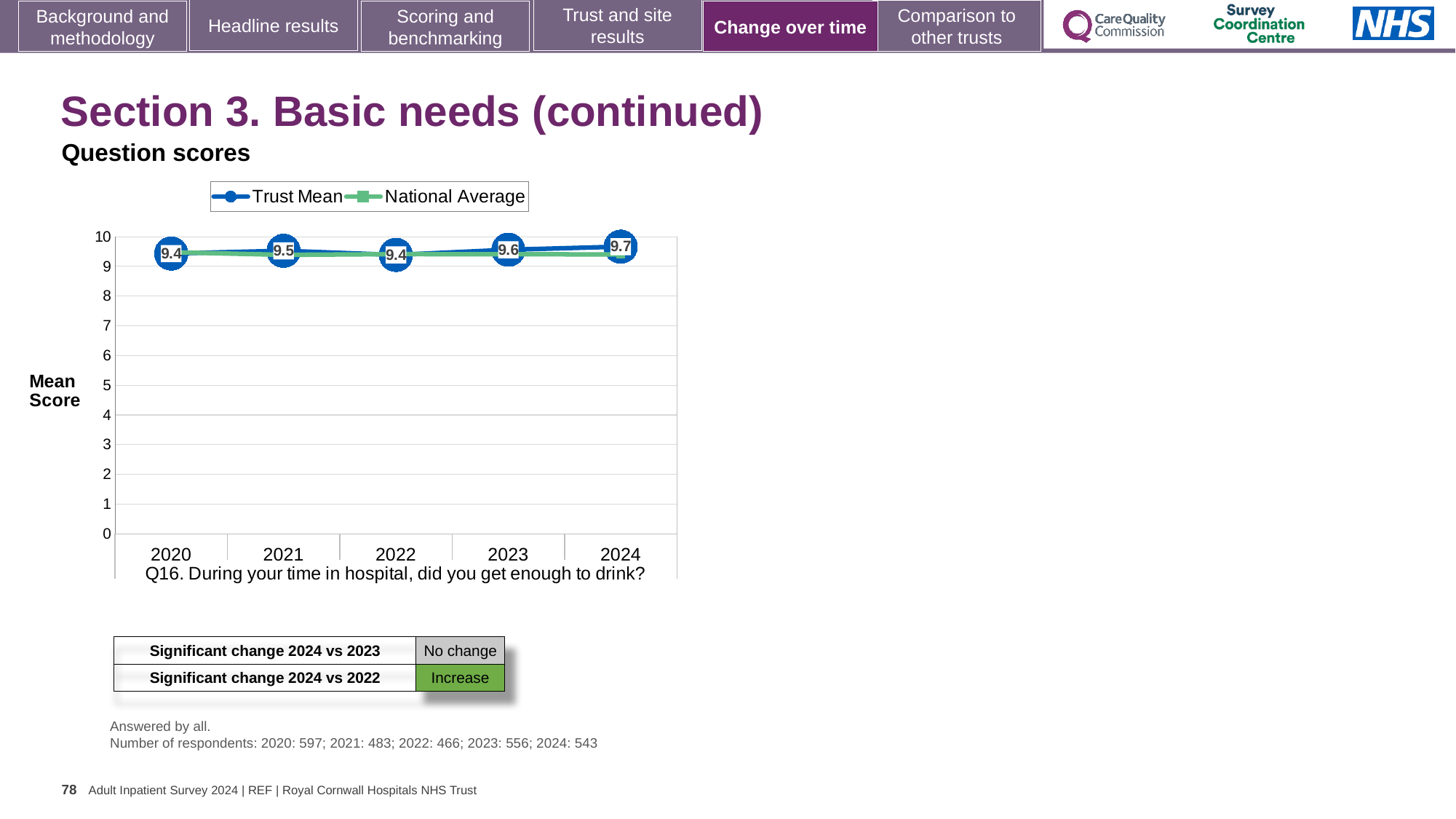
What kind of chart is shown? line chart What is the Trust Mean score for 2023? 9.6 Is the National Average for 2024 greater or less than 8? greater How many years are shown on the x axis? 5 What is the Trust Mean score for 2020? 9.4 What is the Trust Mean score for 2024? 9.7 Is the Trust Mean score for 2021 greater or less than 9? greater How many series does the legend list? 2 In which year is the Trust Mean score highest? 2024 Which question does the chart relate to? Q16. During your time in hospital, did you get enough to drink? Does the Trust Mean score rise or fall from 2022 to 2024? rise What is the difference between the Trust Mean scores for 2024 and 2022? 0.3